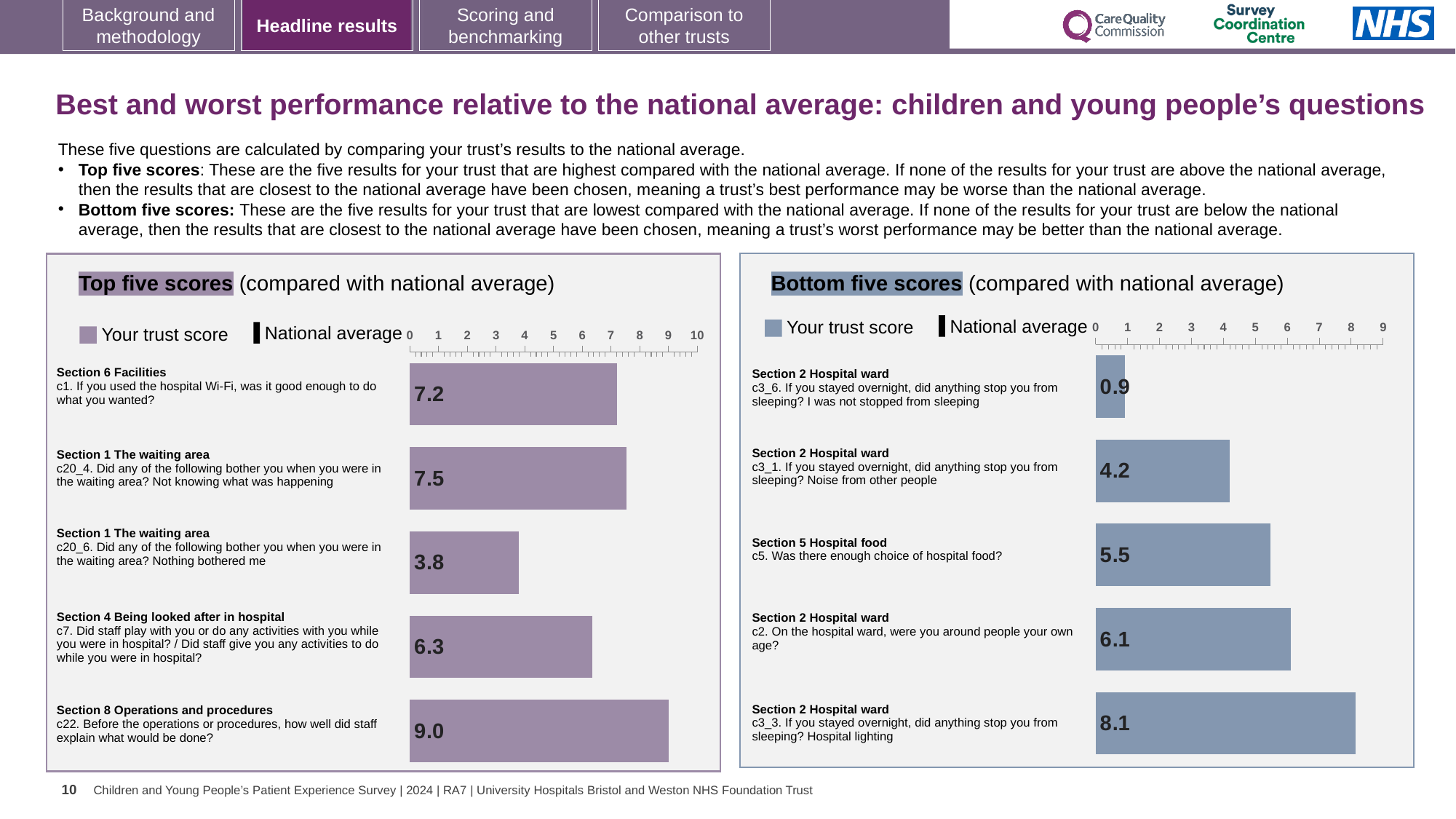
In the Bottom five scores chart, which question has the highest trust score? c3_3. Hospital lighting In the Bottom five scores chart, which has the larger trust score: c3_1 (noise from other people) or c2 (around people your own age)? c2 (around people your own age) How many entries does the legend of the Bottom five scores chart list? 2 What kind of chart is used in the Top five scores panel? Bar chart In the Bottom five scores chart, what is the trust score for c5 (enough choice of hospital food)? 5.5 In the Bottom five scores chart, which question has the lowest trust score? c3_6. I was not stopped from sleeping In the Top five scores chart, how many questions are plotted? 5 In the Top five scores chart, what is the difference between the trust scores for c20_4 and c20_6? 3.7 In the Bottom five scores chart, what is the difference between the trust scores for c3_3 and c3_6? 7.2 In the Top five scores chart, what is the trust score for c1 (hospital Wi-Fi)? 7.2 In the Top five scores chart, what is the trust score for c22 (how well staff explained what would be done before operations)? 9.0 In the Top five scores chart, which question has the lowest trust score? c20_6. Nothing bothered me (waiting area)